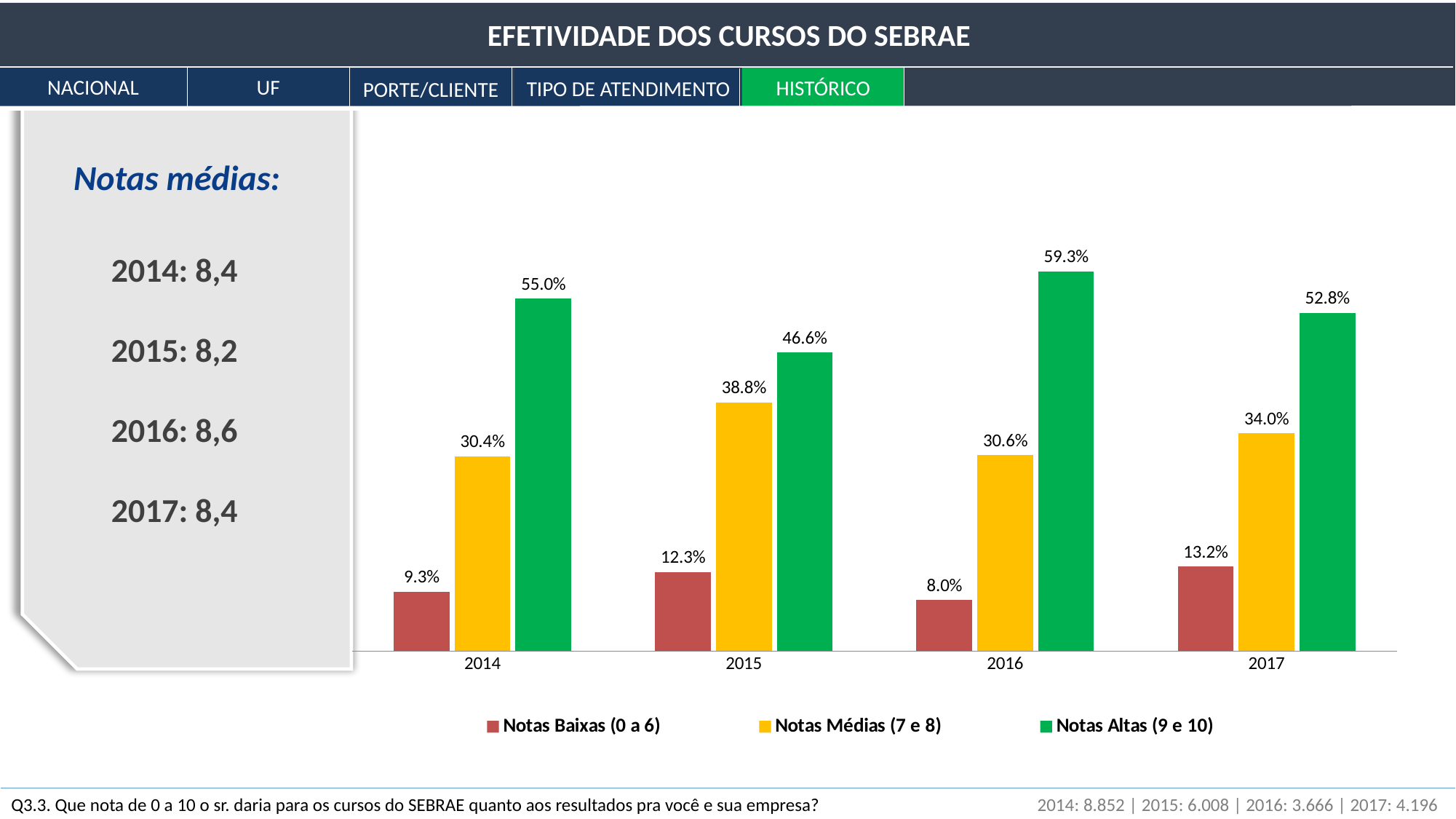
What is the value for Notas Médias (7 e 8) in 2017? 34.0% How many series does the legend list? 3 What is the value for Notas Baixas (0 a 6) in 2015? 12.3% What is the difference between the Notas Altas (9 e 10) values for 2016 and 2015? 12.7% Does the Notas Baixas (0 a 6) value rise or fall from 2016 to 2017? Rise What is the value for Notas Altas (9 e 10) in 2016? 59.3% What kind of chart is shown? Bar chart In which year is the Notas Baixas (0 a 6) value lowest? 2016 What colour represents Notas Altas (9 e 10) in the legend? Green Which is larger: Notas Médias (7 e 8) in 2015 or in 2017? 2015 In which year is the Notas Altas (9 e 10) value highest? 2016 How many years are shown on the x axis? 4